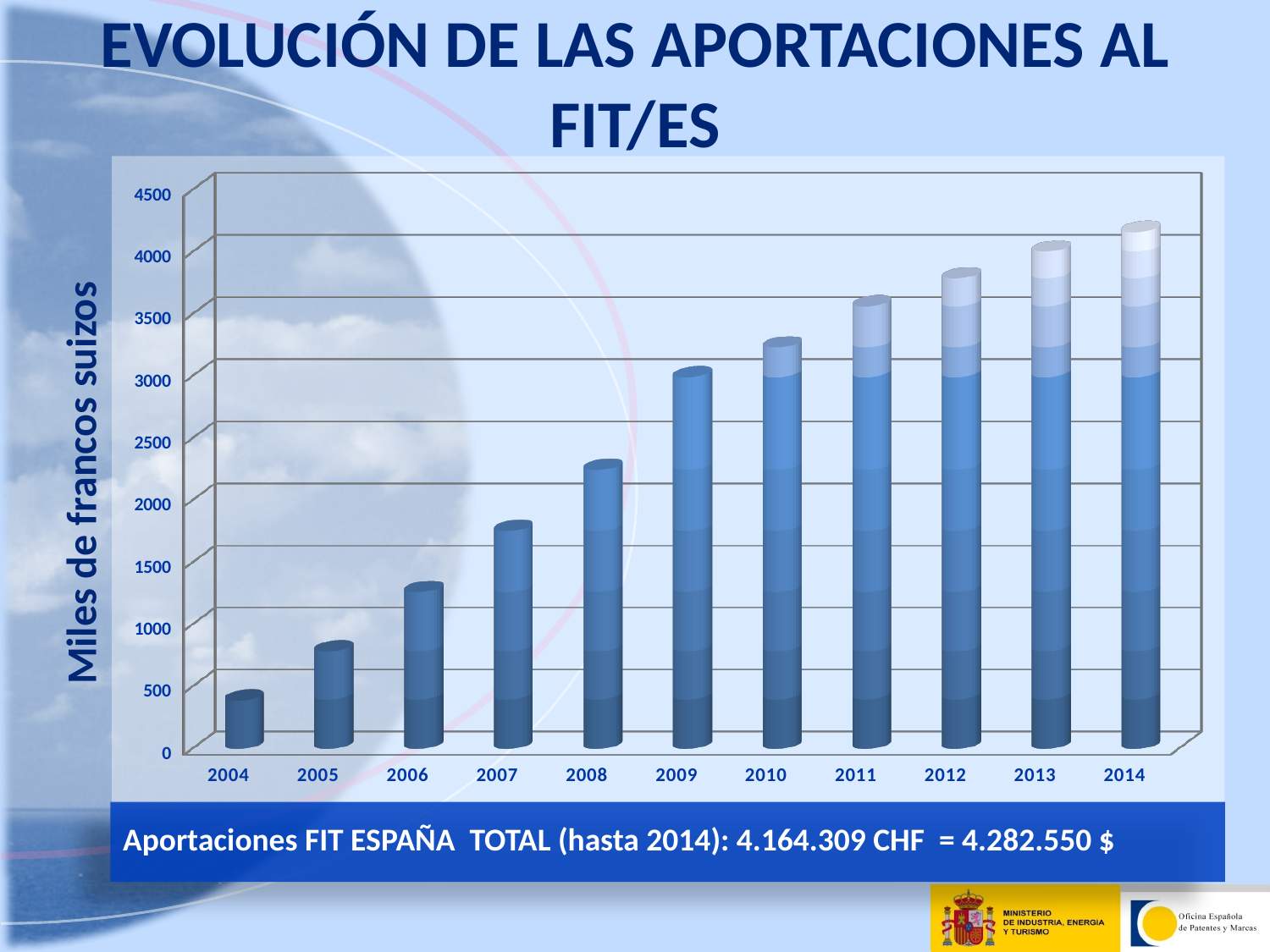
Is the value for 2006 greater or less than 1000? greater Which year has the larger value, 2006 or 2008? 2008 Do the values rise or fall from 2004 to 2014? rise Is the value for 2012 greater or less than 4000? less Is the value for 2004 greater or less than 500? less Which year has the lowest bar in the chart? 2004 Which year has the highest bar in the chart? 2014 How many years are shown on the x axis of the chart? 11 What is the label on the vertical axis of the chart? Miles de francos suizos What kind of chart is shown on the slide? bar chart